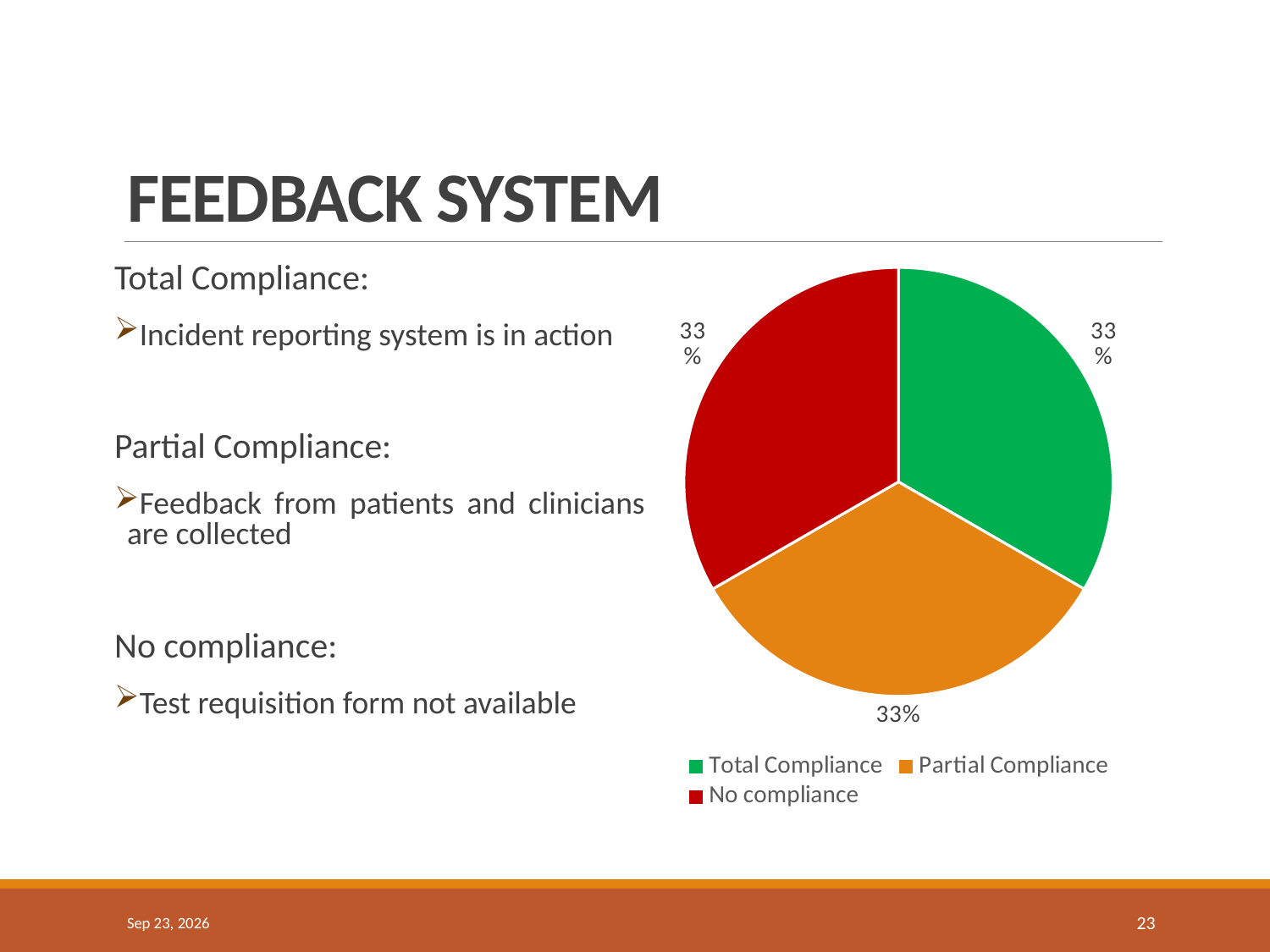
What percentage of the pie chart is No compliance? 33% Which legend entry is shown in red in the pie chart? No compliance What type of chart is shown on the slide? pie chart What percentage of the pie chart is Total Compliance? 33% How many entries does the pie chart's legend list? 3 What colour is the Total Compliance slice in the pie chart? green How many slices does the pie chart have? 3 What percentage of the pie chart is Partial Compliance? 33% What share of the pie does the Partial Compliance slice represent? 33%